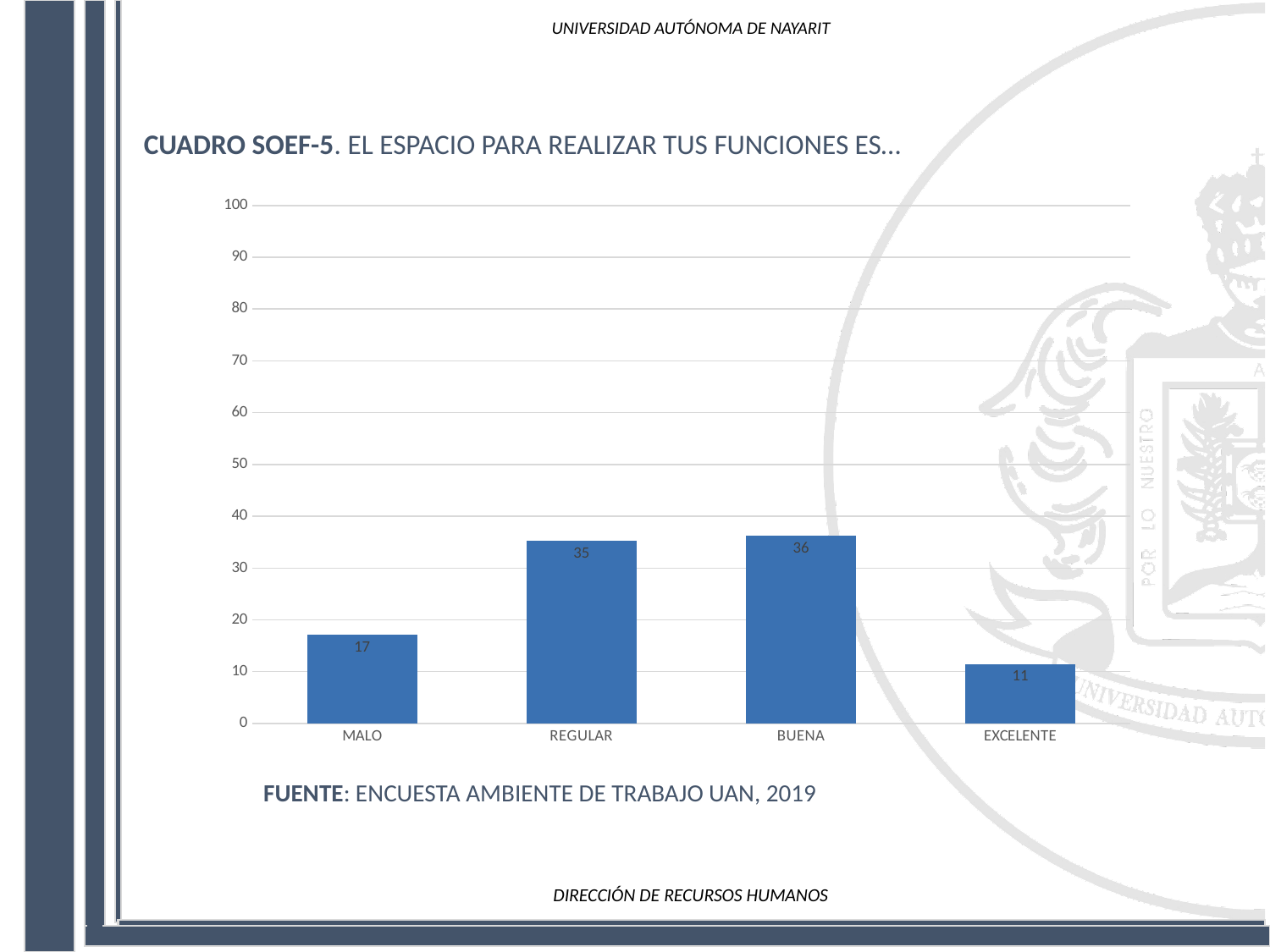
Which is larger, the value for MALO or the value for REGULAR? REGULAR Which category has the lowest value? EXCELENTE How many categories are shown on the x axis? 4 What is the difference between the values for MALO and EXCELENTE? 6 Is the value for REGULAR greater or less than 40? less What is the value for REGULAR? 35 Which category has the highest value? BUENA What is the value for MALO? 17 What kind of chart is shown on the slide? bar chart What is the value for EXCELENTE? 11 What is the value for BUENA? 36 What is the difference between the values for BUENA and MALO? 19